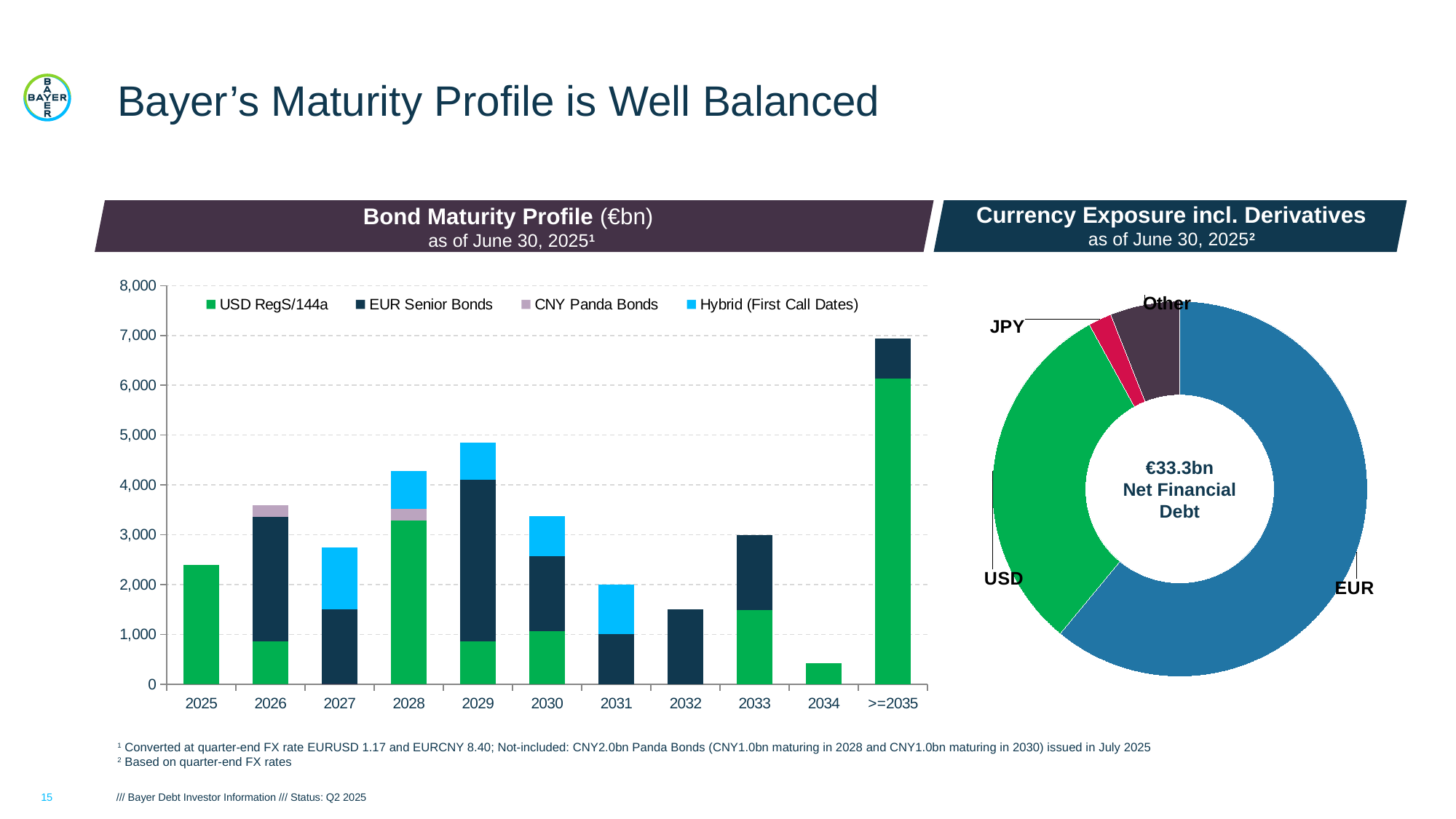
How many series does the legend of the Bond Maturity Profile chart list? 4 What value is printed in the centre of the Currency Exposure incl. Derivatives donut chart? €33.3bn Net Financial Debt How many maturity categories are shown on the x axis of the Bond Maturity Profile chart? 11 In the Bond Maturity Profile chart, which maturity category has the tallest stacked bar? >=2035 In the Bond Maturity Profile chart, which stacked bar is taller, 2026 or 2027? 2026 In the Bond Maturity Profile chart, is the total bar for >=2035 greater or less than 6,000? greater What kind of chart is the Bond Maturity Profile chart? Stacked bar chart In the Bond Maturity Profile chart, which maturity category has the shortest stacked bar? 2034 In the Bond Maturity Profile chart, is the total bar for 2025 greater or less than 2,000? greater In the Bond Maturity Profile chart, is the total bar for 2032 greater or less than 2,000? less In the Currency Exposure incl. Derivatives chart, which currency has the largest share? EUR What kind of chart is the Currency Exposure incl. Derivatives chart? Donut chart